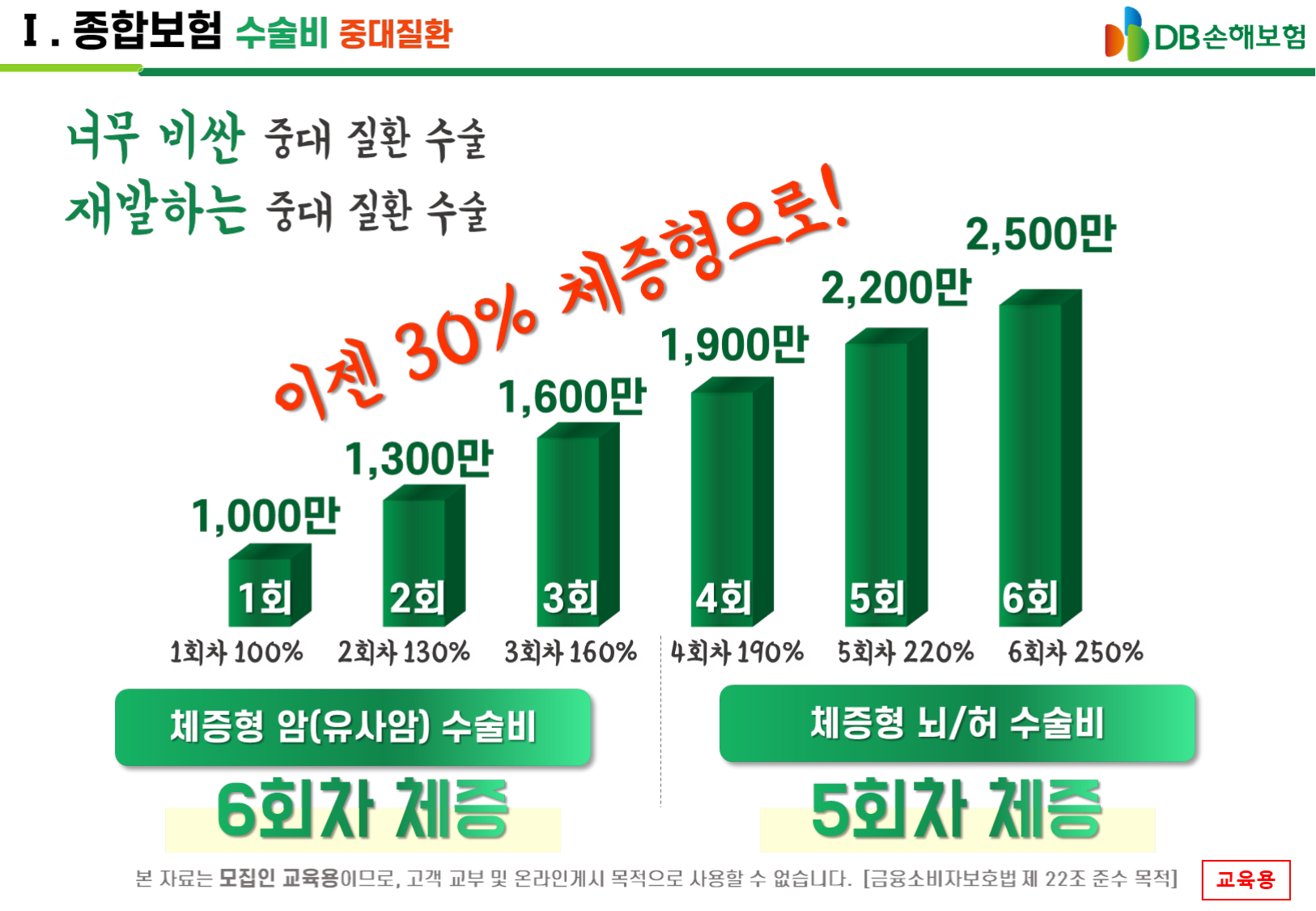
What value is shown for the 4회 bar? 1,900만 Which is larger, the value for 5회 or the value for 4회? 5회 Which bar has the lowest value? 1회 What percentage is shown below the 3회 bar (3회차)? 160% What kind of chart is shown on the slide? Bar chart What is the difference between the 6회 value and the 1회 value? 1,500만 How many bars are shown in the chart? 6 What value is shown for the 6회 bar? 2,500만 Which bar has the highest value? 6회 What is the difference between the 3회 value and the 2회 value? 300만 Do the values rise or fall from 1회 to 6회? Rise What value is shown for the 1회 bar? 1,000만